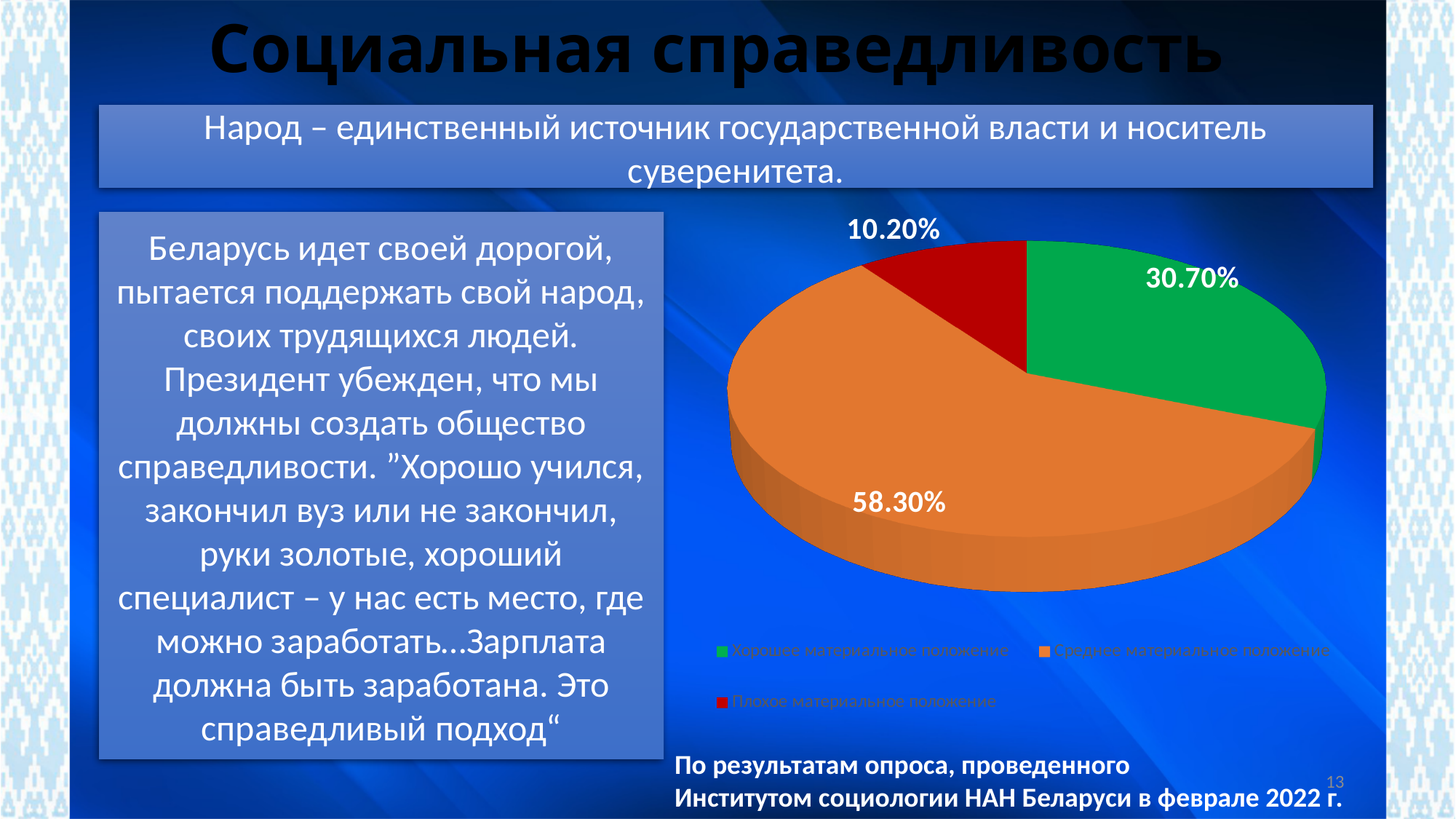
What share of the pie is labelled "Плохое материальное положение"? 10.20% What colour is the slice for "Плохое материальное положение"? red Which category has the smallest slice of the pie? Плохое материальное положение How many entries does the chart legend list? 3 What is the difference between the shares for "Хорошее материальное положение" and "Плохое материальное положение"? 20.50% Which is larger: the share for "Хорошее материальное положение" or for "Плохое материальное положение"? Хорошее материальное положение What share of the pie is labelled "Хорошее материальное положение"? 30.70% Which category has the largest slice of the pie? Среднее материальное положение What is the difference between the shares for "Среднее материальное положение" and "Хорошее материальное положение"? 27.60% What kind of chart is shown on the slide? pie chart How many slices does the pie chart have? 3 What share of the pie is labelled "Среднее материальное положение"? 58.30%